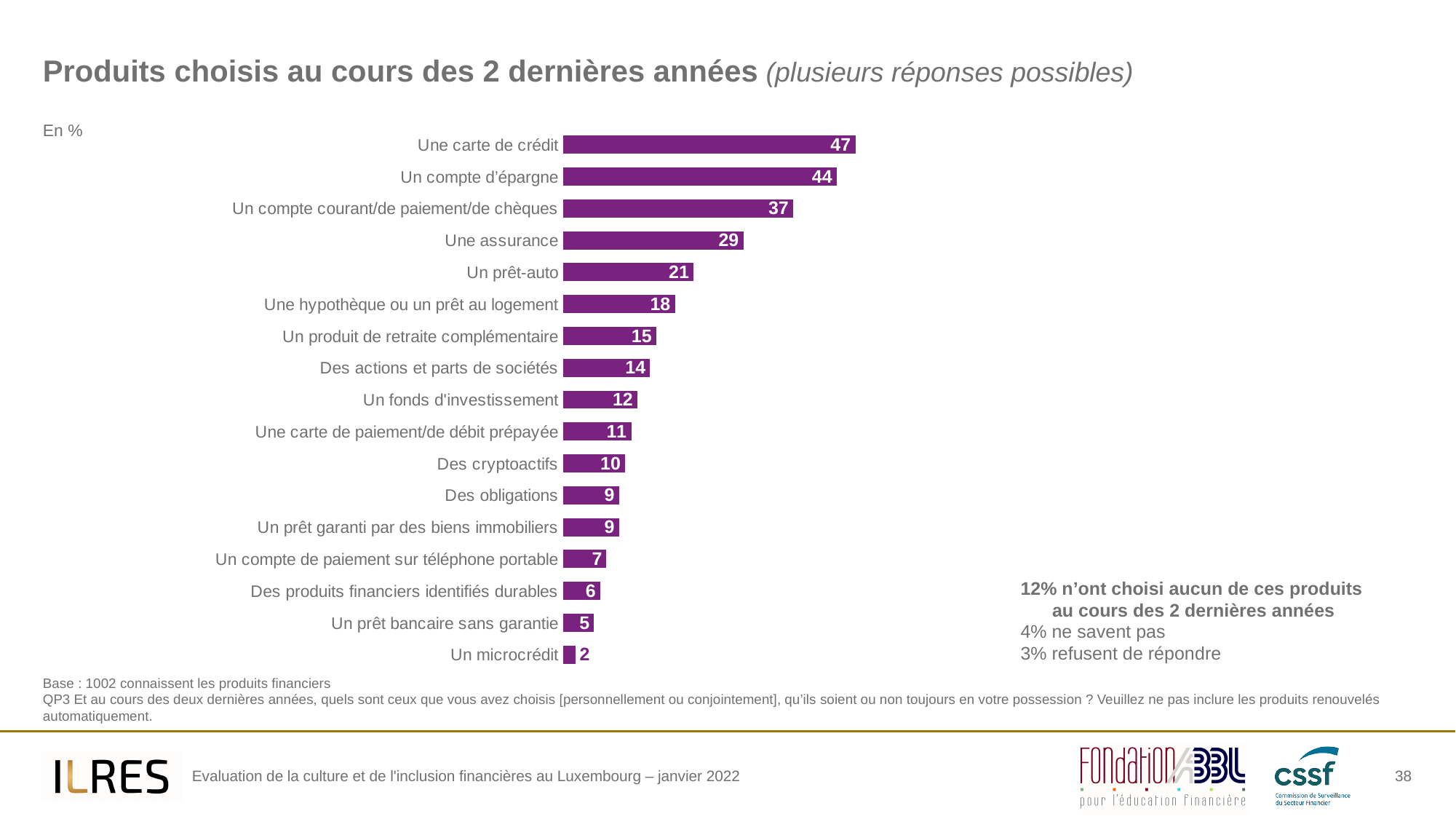
What is the value for "Des cryptoactifs"? 10 Which category has the lowest value? Un microcrédit What is the title of the chart? Produits choisis au cours des 2 dernières années (plusieurs réponses possibles) What is the difference between the values for "Un compte d'épargne" and "Une assurance"? 15 What is the difference between the values for "Une hypothèque ou un prêt au logement" and "Un microcrédit"? 16 What kind of chart is shown on the slide? Bar chart How many categories are shown in the chart? 17 What is the value for "Un prêt-auto"? 21 Which category has the highest value? Une carte de crédit What colour are the bars in the chart? Purple What is the value for "Une carte de crédit"? 47 Which is larger: the value for "Un fonds d'investissement" or the value for "Des actions et parts de sociétés"? Des actions et parts de sociétés